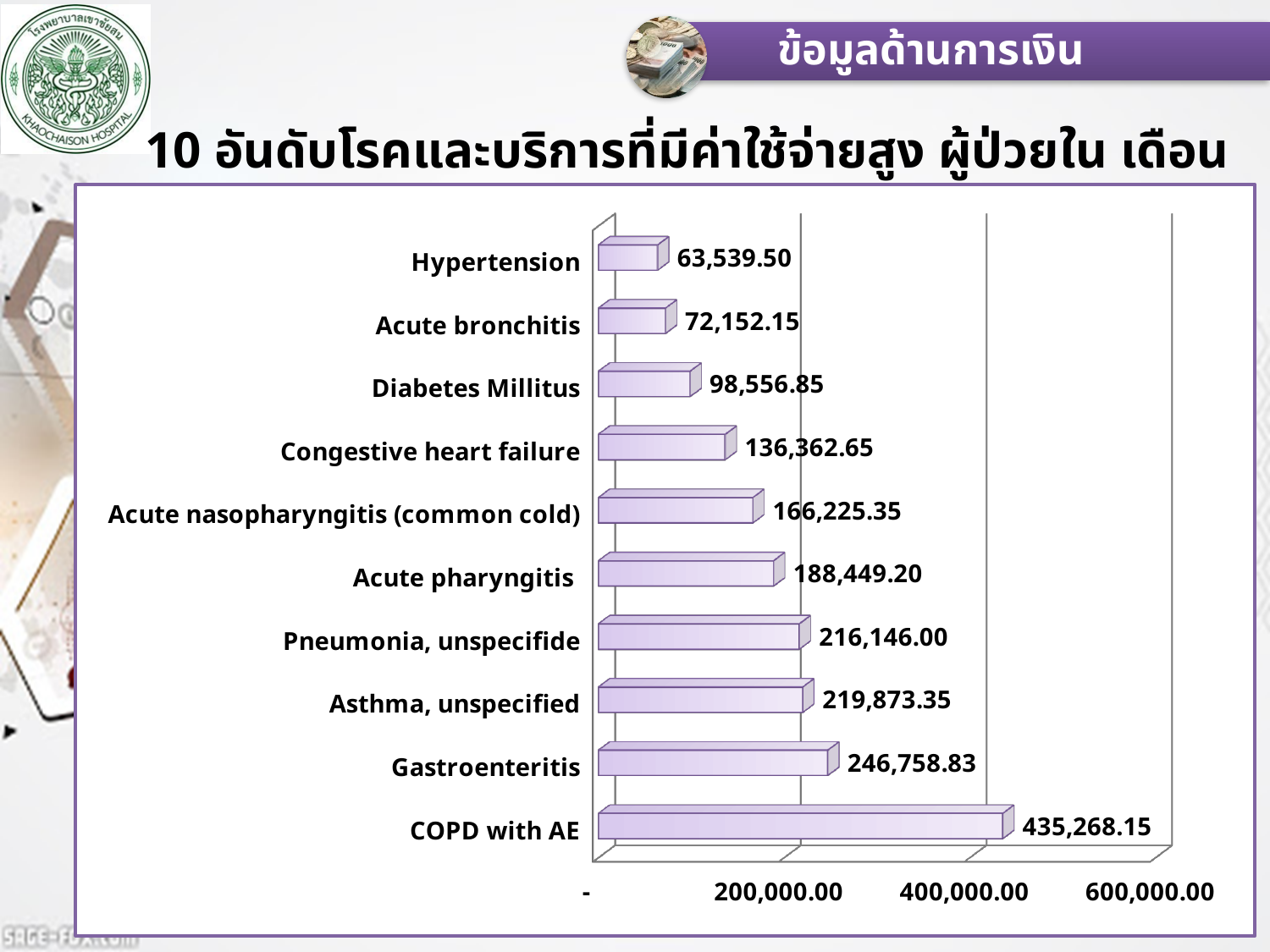
Which is larger, the value for Gastroenteritis or the value for Acute pharyngitis? Gastroenteritis What is the value for COPD with AE? 435,268.15 What kind of chart is shown on the slide? Bar chart What is the difference between the values for COPD with AE and Gastroenteritis? 188,509.32 What is the difference between the values for Acute bronchitis and Hypertension? 8,612.65 Which category has the highest value? COPD with AE What is the value for Congestive heart failure? 136,362.65 What is the value for Diabetes Millitus? 98,556.85 How many categories are shown in the chart? 10 What is the value for Acute nasopharyngitis (common cold)? 166,225.35 Is the value for COPD with AE greater or less than 400,000.00? greater Which category has the lowest value? Hypertension